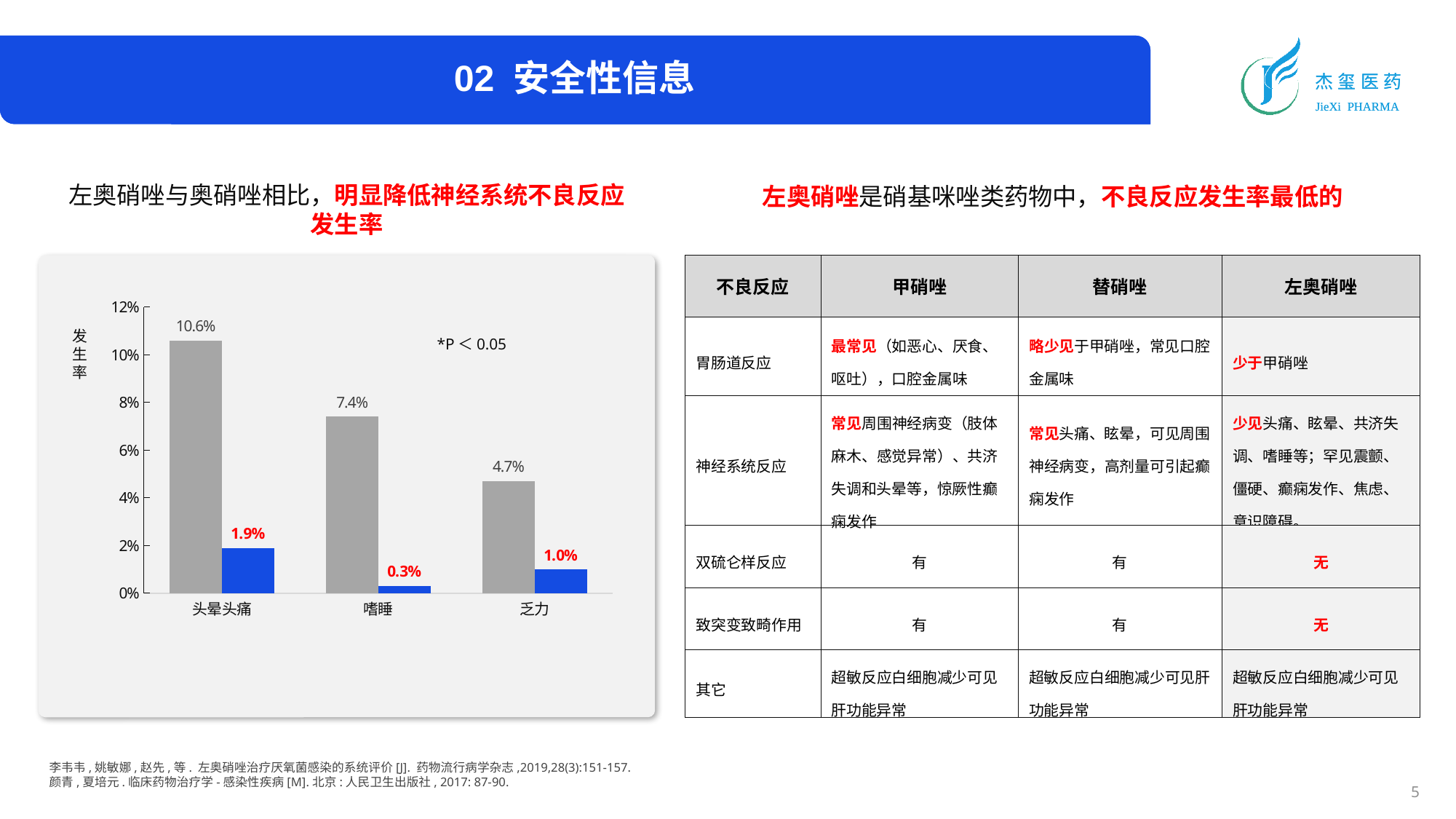
Do the gray bar values rise or fall from 头晕头痛 to 乏力? fall How many categories are shown on the x axis of the bar chart? 3 What kind of chart is shown on the left of the slide? bar chart Which category has the lowest blue bar? 嗜睡 What is the difference between the gray bar and the blue bar for 头晕头痛? 8.7% What is the value of the blue bar for 乏力? 1.0% What is the difference between the gray bar values for 嗜睡 and 乏力? 2.7% Which category has the highest gray bar? 头晕头痛 Which is larger, the blue bar for 头晕头痛 or the blue bar for 乏力? 头晕头痛 Is the gray bar for 乏力 greater or less than 6%? less What is the value of the blue bar for 嗜睡? 0.3% What is the value of the gray bar for 头晕头痛? 10.6%